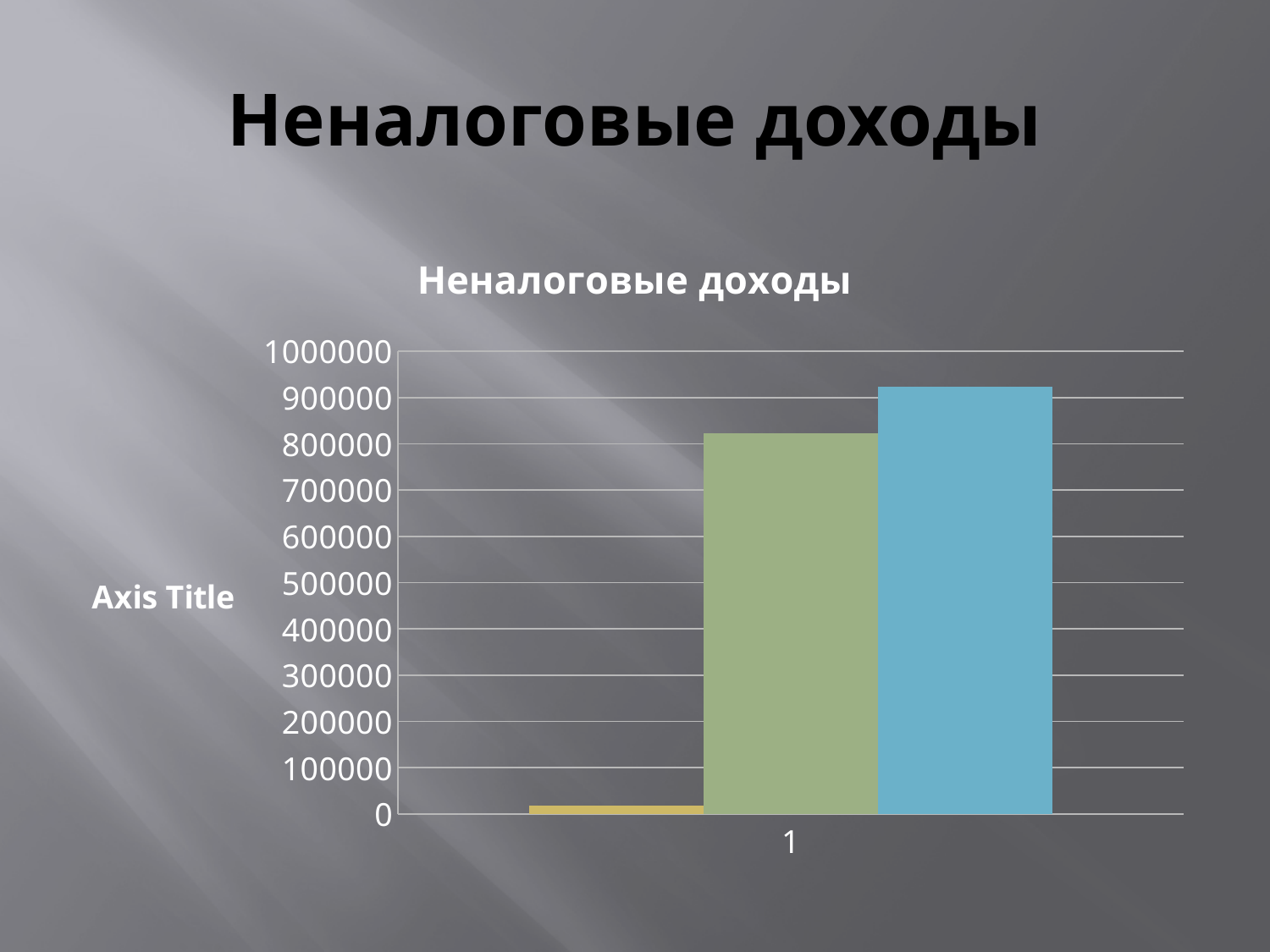
Is the value of the yellow bar greater or less than 100000? less What is the highest value shown on the vertical axis? 1000000 Is the value of the green bar greater or less than 800000? greater How many bars are plotted in the chart? 3 What is the label shown on the vertical axis? Axis Title Which is larger, the green bar or the blue bar? blue bar What kind of chart is shown on the slide? bar chart What is the title of the chart? Неналоговые доходы Which bar is the shortest: the yellow, green or blue one? yellow Which bar is the tallest: the yellow, green or blue one? blue How many categories are shown on the x axis? 1 Is the value of the blue bar greater or less than 900000? greater